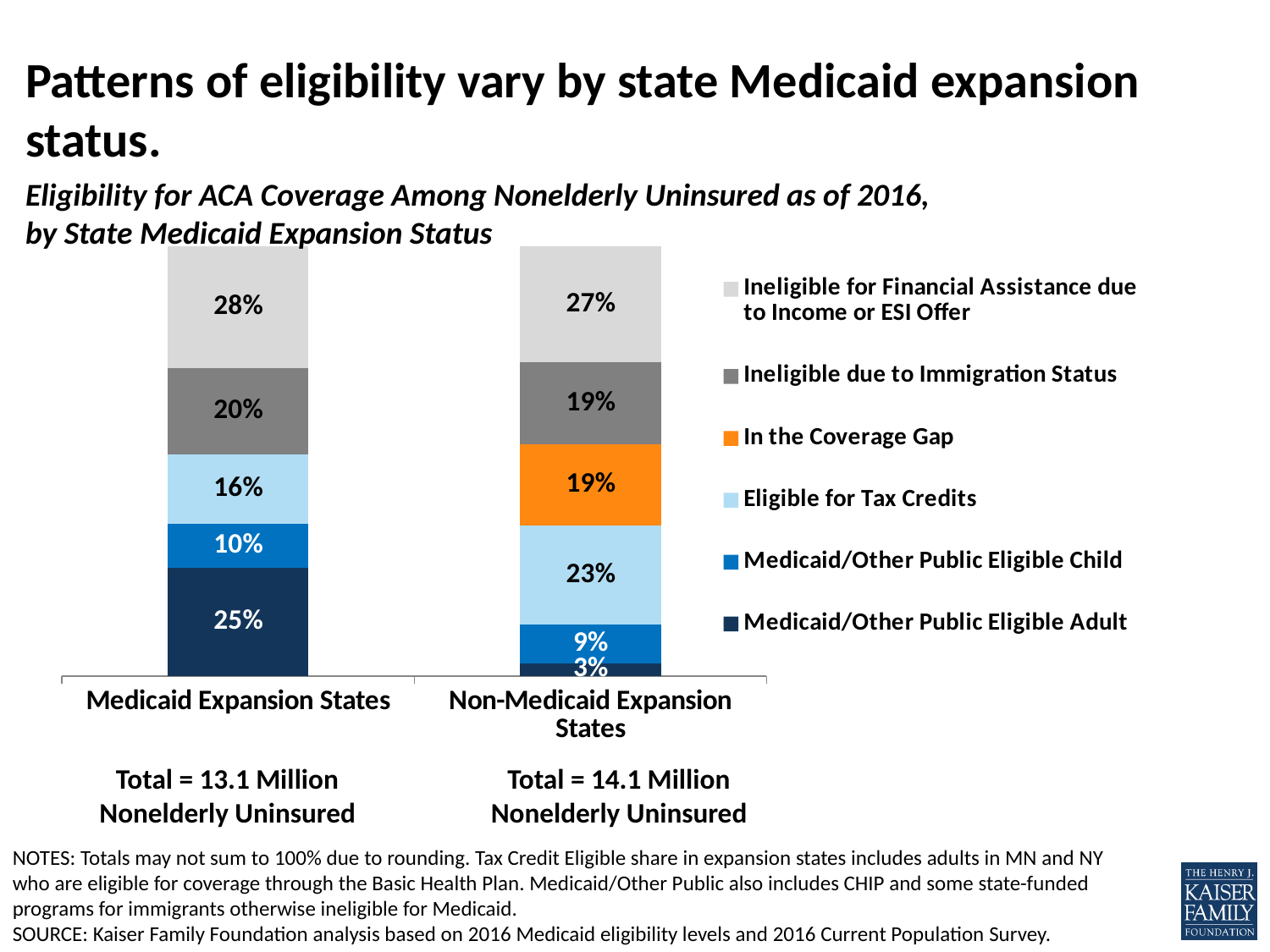
What kind of chart is shown on the slide? Stacked bar chart Which state group has the larger Medicaid/Other Public Eligible Adult share? Medicaid Expansion States What share of the nonelderly uninsured in Non-Medicaid Expansion States is Eligible for Tax Credits? 23% Which segment is the smallest in the Non-Medicaid Expansion States bar? Medicaid/Other Public Eligible Adult What is the total number of nonelderly uninsured in Non-Medicaid Expansion States shown below the chart? 14.1 Million What share of the nonelderly uninsured in Medicaid Expansion States is Ineligible due to Immigration Status? 20% What share of the nonelderly uninsured in Medicaid Expansion States is Medicaid/Other Public Eligible Adult? 25% Which segment is the largest in the Medicaid Expansion States bar? Ineligible for Financial Assistance due to Income or ESI Offer What share of the nonelderly uninsured in Non-Medicaid Expansion States is In the Coverage Gap? 19% How many bars (state groups) are shown in the chart? 2 What is the difference between the Eligible for Tax Credits share in Non-Medicaid Expansion States and in Medicaid Expansion States? 7 percentage points How many series does the legend list? 6